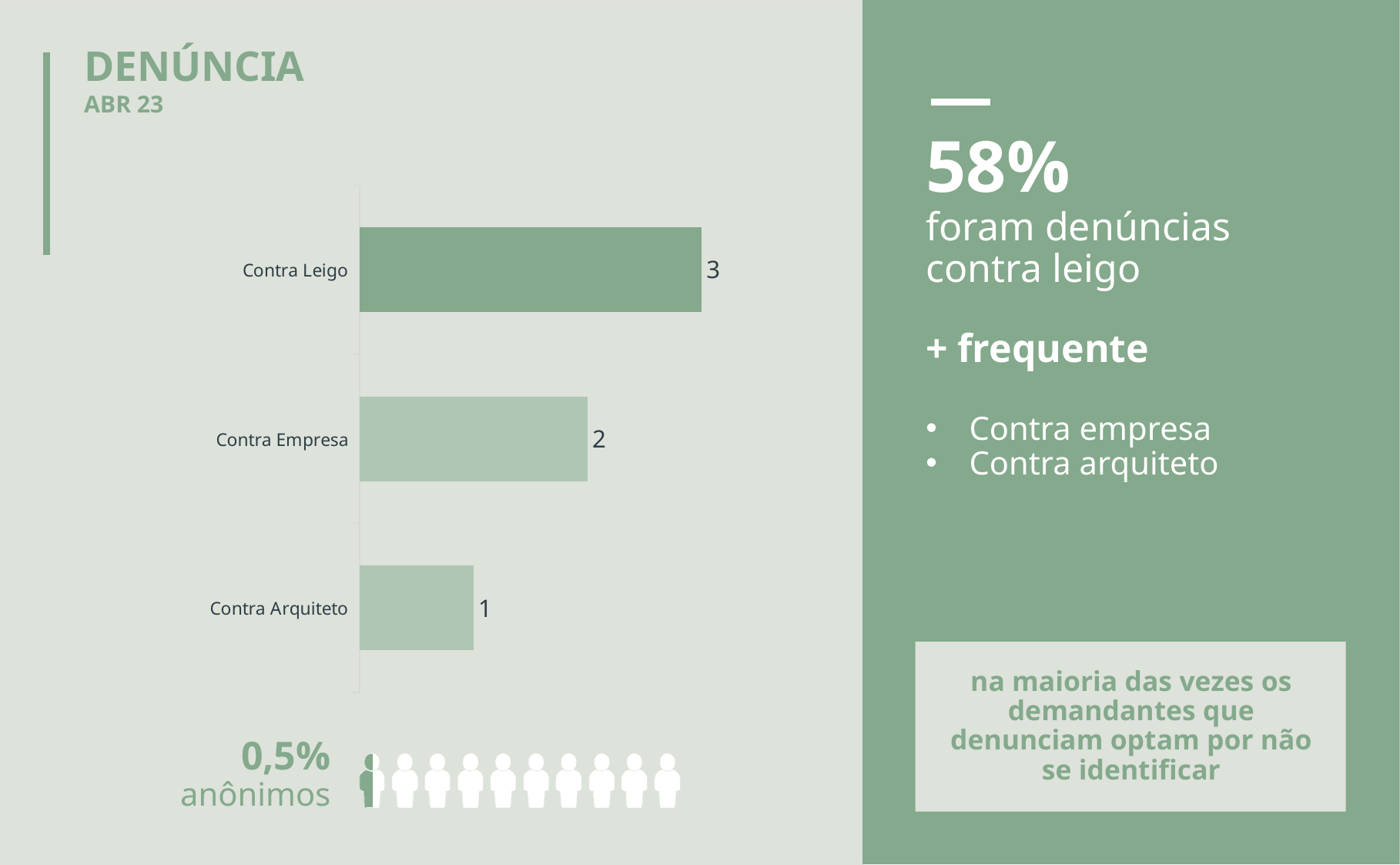
How many categories are shown in the chart? 3 What is the difference between the values for Contra Leigo and Contra Arquiteto? 2 What is the value for Contra Empresa? 2 Which category has the lowest value? Contra Arquiteto What is the value for Contra Leigo? 3 What is the value for Contra Arquiteto? 1 Which category has the highest value? Contra Leigo Which is larger, the value for Contra Empresa or the value for Contra Arquiteto? Contra Empresa What is the difference between the values for Contra Empresa and Contra Arquiteto? 1 What is the total of the three values shown in the chart? 6 What kind of chart is shown on the slide? bar chart What is the title of the slide containing the chart? DENÚNCIA